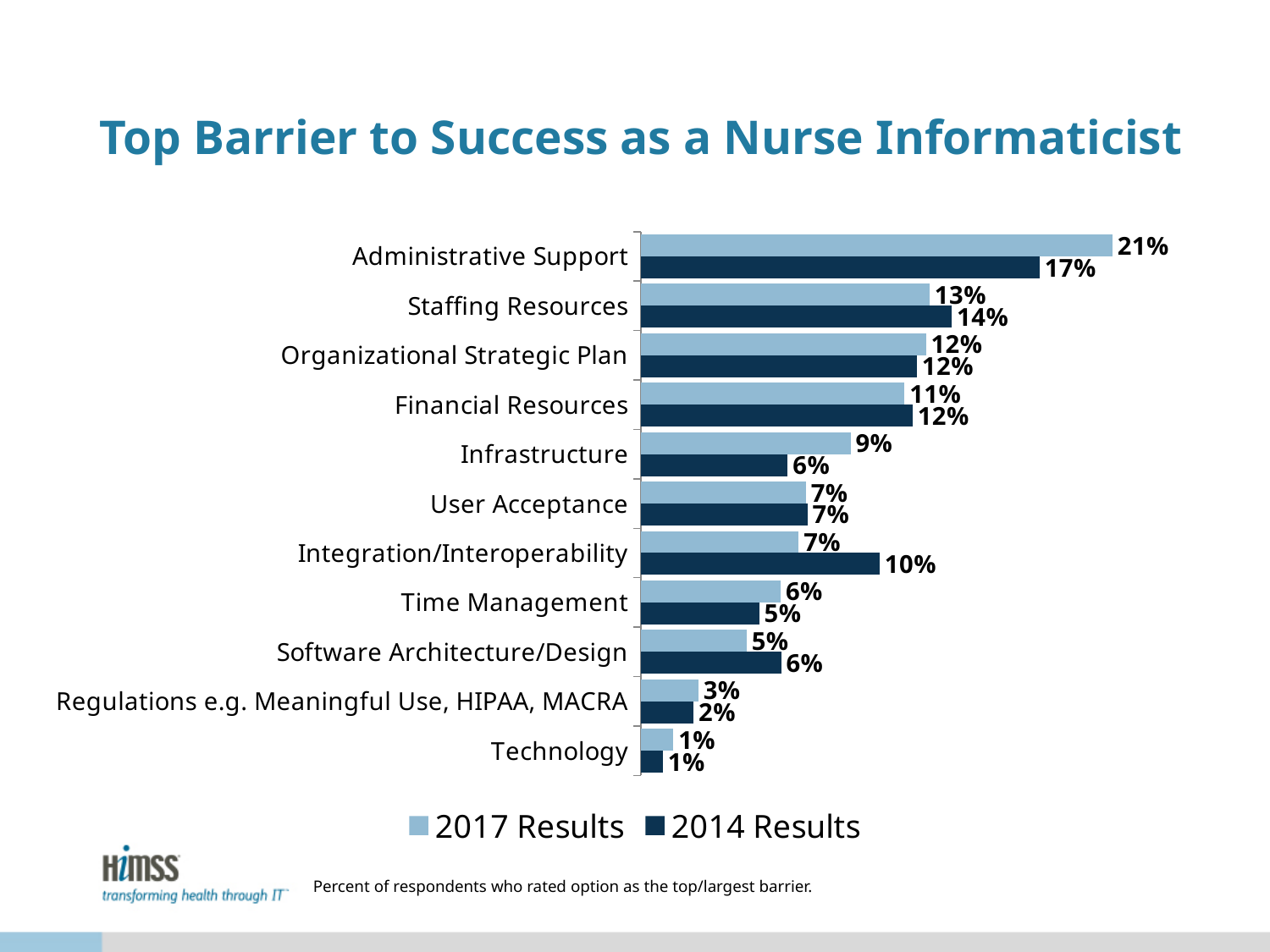
What is the 2017 Results value for Infrastructure? 9% What is the difference between the 2014 Results and 2017 Results values for Integration/Interoperability? 3% How many series does the legend list? 2 Which category has the lowest 2014 Results value? Technology Which category has the highest 2017 Results value? Administrative Support What is the difference between the 2017 Results and 2014 Results values for Administrative Support? 4% How many categories are shown on the chart? 11 Which is larger for Staffing Resources: the 2017 Results value or the 2014 Results value? 2014 Results What kind of chart is shown on the slide? Bar chart What is the title of the chart? Top Barrier to Success as a Nurse Informaticist What is the 2014 Results value for Integration/Interoperability? 10% What is the 2017 Results value for Administrative Support? 21%